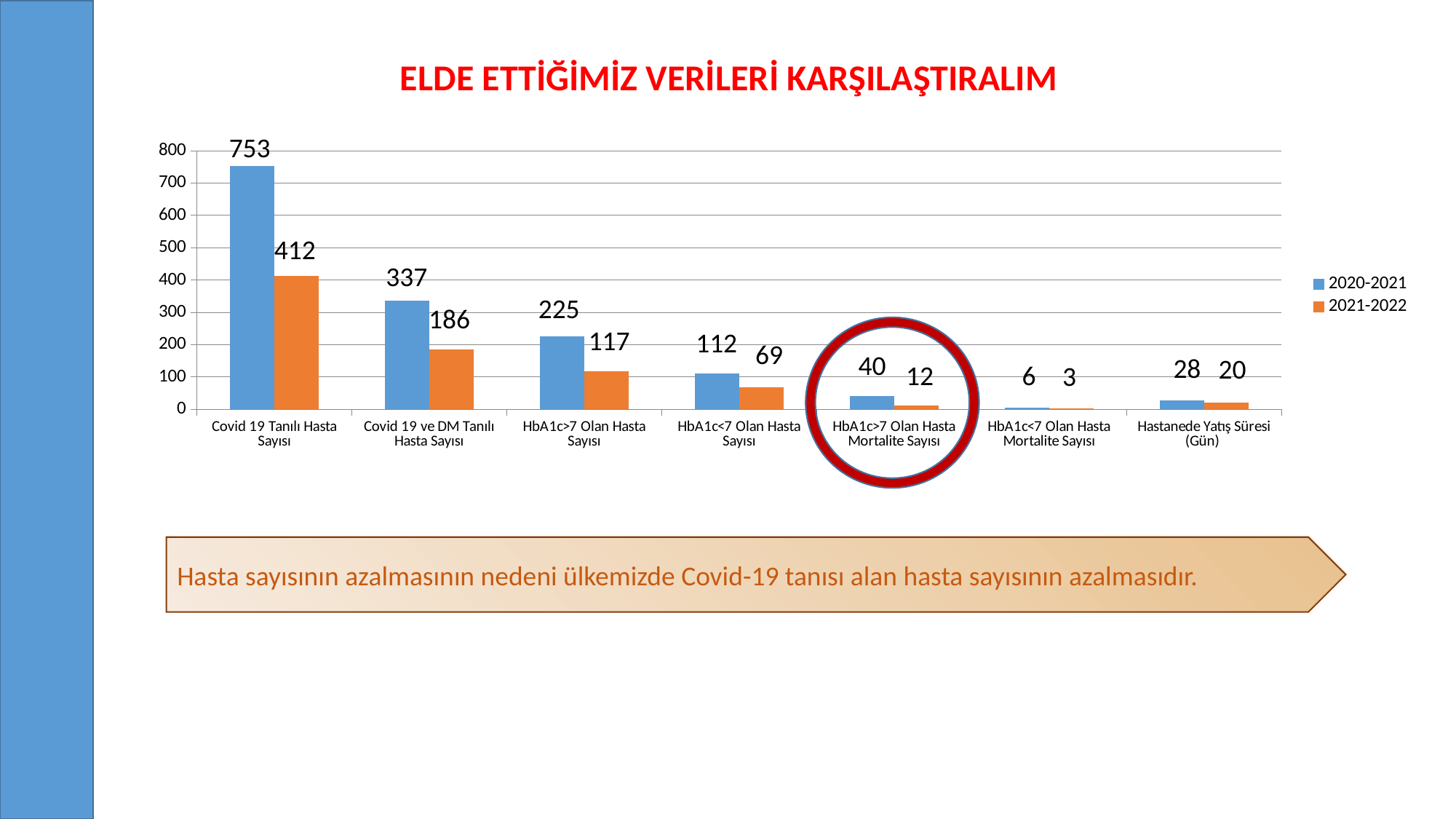
Which is larger: the 2020-2021 value for HbA1c<7 Olan Hasta Sayısı or the 2021-2022 value for HbA1c>7 Olan Hasta Sayısı? 2021-2022 value for HbA1c>7 Olan Hasta Sayısı Which category has the lowest 2021-2022 value? HbA1c<7 Olan Hasta Mortalite Sayısı How many series does the legend list? 2 What is the difference between the 2020-2021 and 2021-2022 values for HbA1c>7 Olan Hasta Sayısı? 108 What is the difference between the 2020-2021 and 2021-2022 values for Covid 19 Tanılı Hasta Sayısı? 341 What is the 2021-2022 value for HbA1c>7 Olan Hasta Mortalite Sayısı? 12 How many categories are shown on the x axis? 7 What is the 2021-2022 value for Covid 19 ve DM Tanılı Hasta Sayısı? 186 Which category has the highest 2020-2021 value? Covid 19 Tanılı Hasta Sayısı What kind of chart is shown on the slide? Bar chart What is the 2020-2021 value for Hastanede Yatış Süresi (Gün)? 28 What is the 2020-2021 value for Covid 19 Tanılı Hasta Sayısı? 753